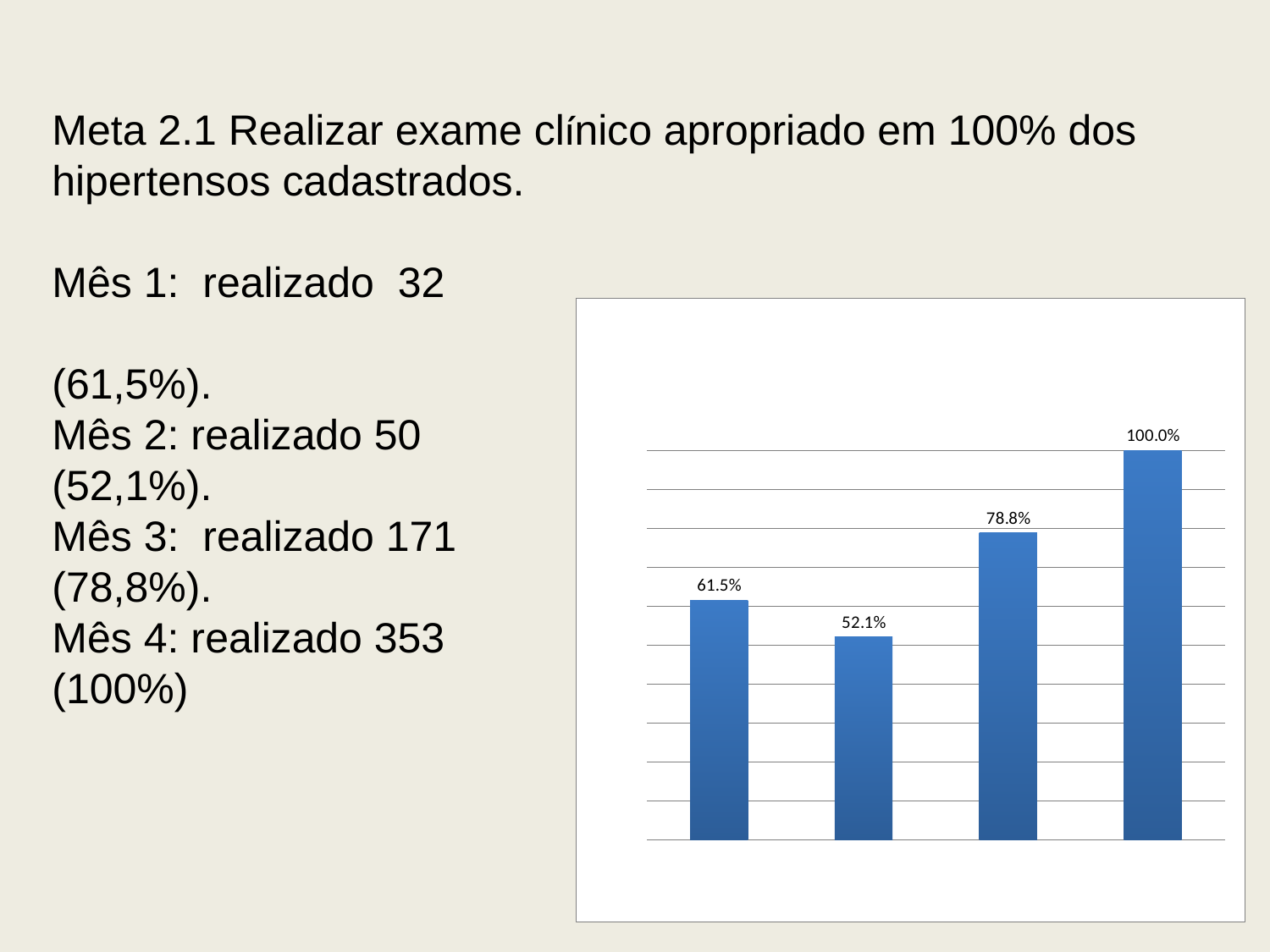
What is the value labelled on the fourth (rightmost) bar of the chart? 100.0% What is the value labelled on the third bar of the chart? 78.8% Which is larger, the value of the first bar or the value of the second bar? the first bar (61.5%) What is the value labelled on the first (leftmost) bar of the chart? 61.5% How many bars does the chart show? 4 Which bar in the chart has the highest value? the fourth (rightmost) bar, 100.0% What is the difference between the fourth bar (100.0%) and the third bar (78.8%)? 21.2 percentage points What is the difference between the first bar (61.5%) and the second bar (52.1%)? 9.4 percentage points What is the value labelled on the second bar of the chart? 52.1% Which bar in the chart has the lowest value? the second bar, 52.1% What kind of chart is shown on the slide? bar chart Do the values rise or fall from the second bar to the fourth bar? rise